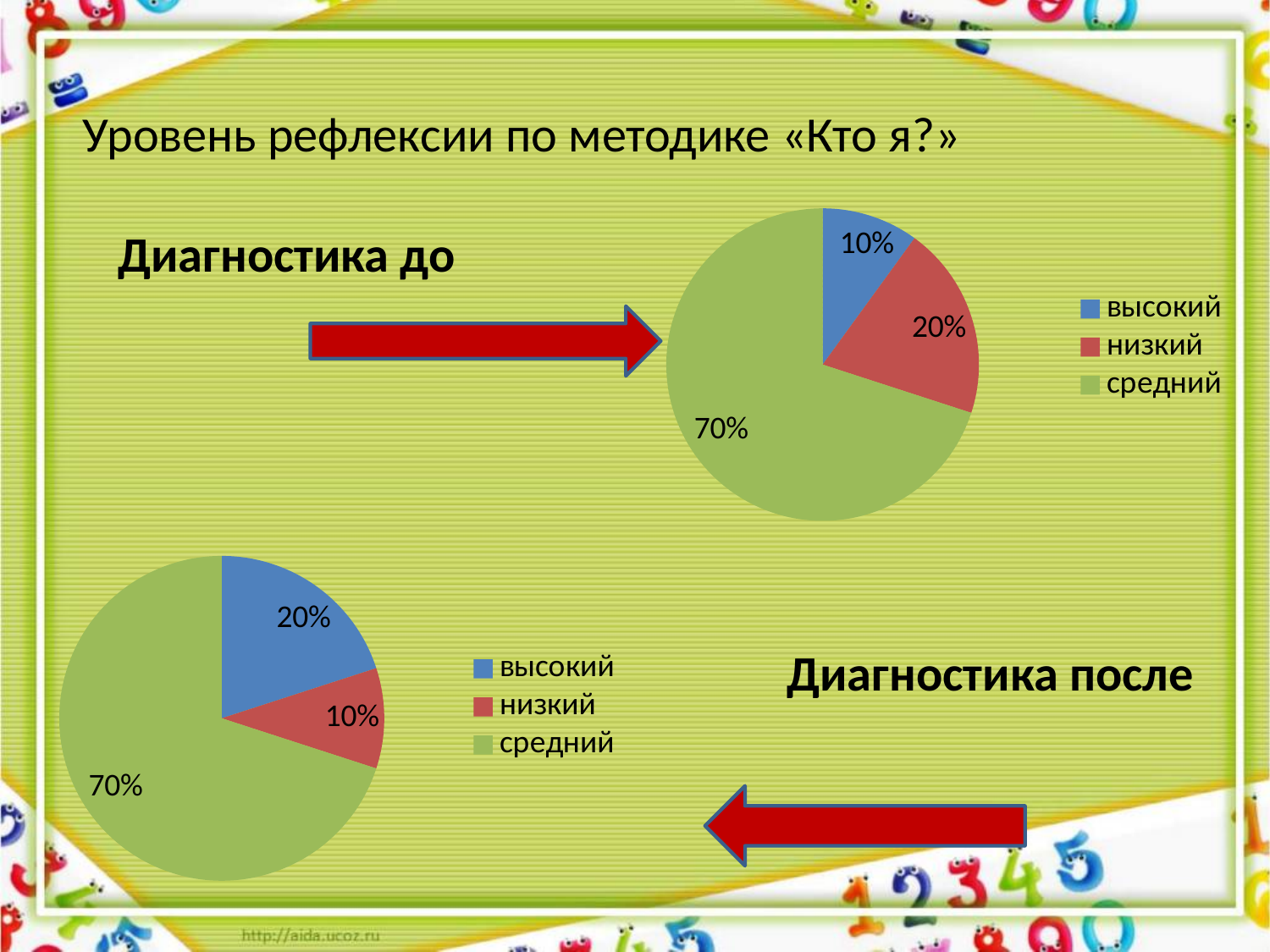
In the 'Диагностика после' pie chart, what share does 'высокий' have? 20% In the 'Диагностика после' pie chart, what share does 'низкий' have? 10% What type of chart is used for 'Диагностика после'? pie chart In the 'Диагностика до' pie chart, which category has the smallest slice? высокий In the 'Диагностика до' pie chart, what share does 'низкий' have? 20% In the 'Диагностика до' pie chart, what share does 'высокий' have? 10% In the 'Диагностика после' pie chart, which is larger: 'высокий' or 'низкий'? высокий How many categories does the legend of the 'Диагностика до' chart list? 3 In the 'Диагностика после' pie chart, which category has the largest slice? средний In the 'Диагностика после' pie chart, which category has the smallest slice? низкий In the 'Диагностика до' pie chart, what is the difference between the 'средний' and 'низкий' shares? 50% In the 'Диагностика до' pie chart, what share does 'средний' have? 70%